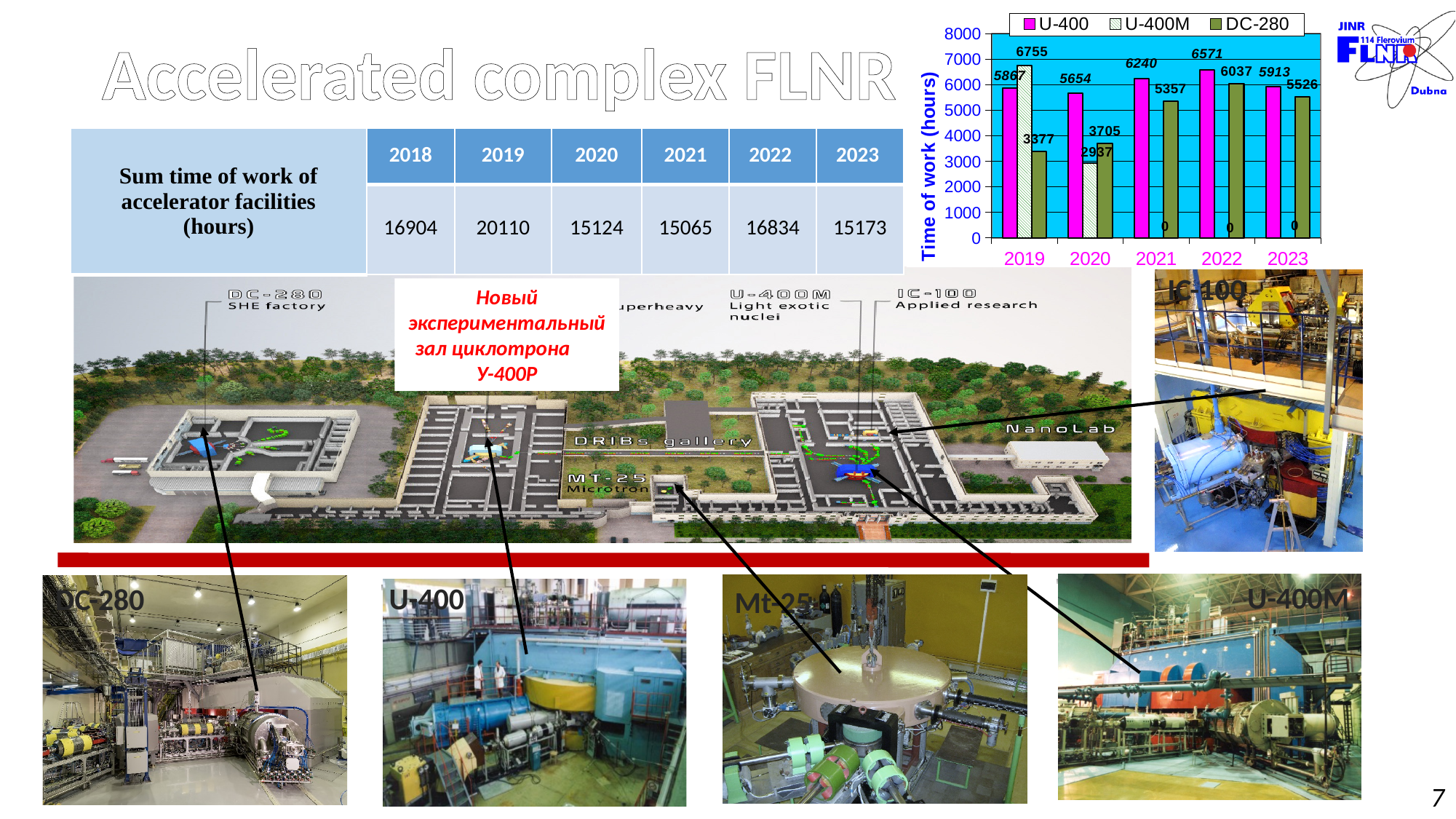
What is the time of work for DC-280 in 2019? 3377 How many series does the chart legend list? 3 What is the time of work for U-400 in 2022? 6571 What is the U-400M value in 2021, 2022 and 2023? 0 In which year is the DC-280 value lowest? 2019 What is the label of the y axis of the chart? Time of work (hours) In which year is the U-400 value highest? 2022 What is the difference between the U-400 and DC-280 values in 2021? 883 What type of chart is shown in the top right of the slide? bar chart Which is larger in 2019, the U-400 value or the U-400M value? U-400M What is the time of work for U-400M in 2020? 2937 How many years are shown on the x axis of the chart? 5